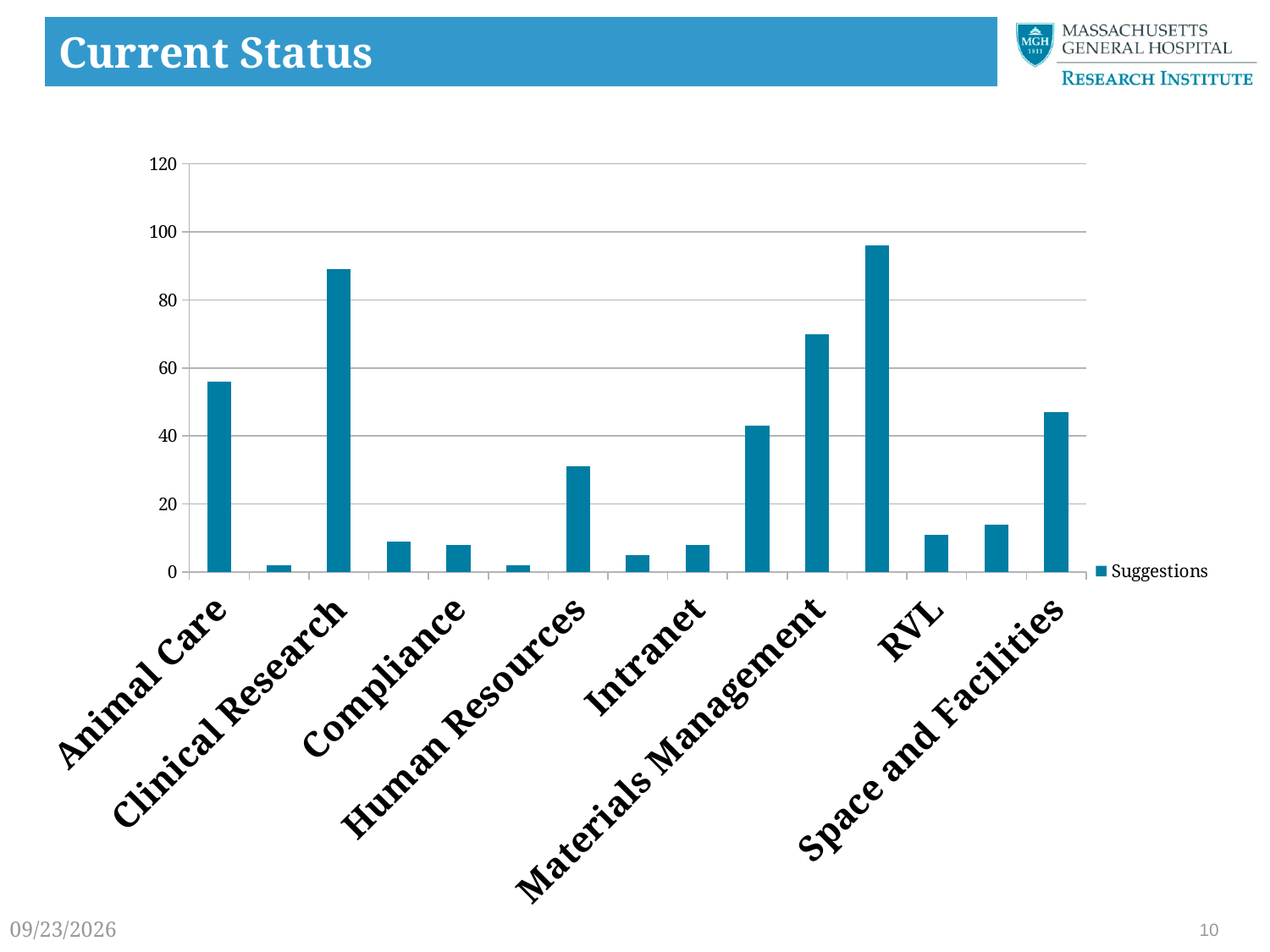
Is the value for Human Resources greater or less than 20? greater Which has the larger value, Clinical Research or Animal Care? Clinical Research Which has the larger value, Materials Management or Space and Facilities? Materials Management What kind of chart is shown on the slide? bar chart How many series does the legend list? 1 How many bars are plotted in the chart? 15 Is the value for Clinical Research greater or less than 80? greater Is the value for Compliance greater or less than 20? less What is the name of the series shown in the legend? Suggestions